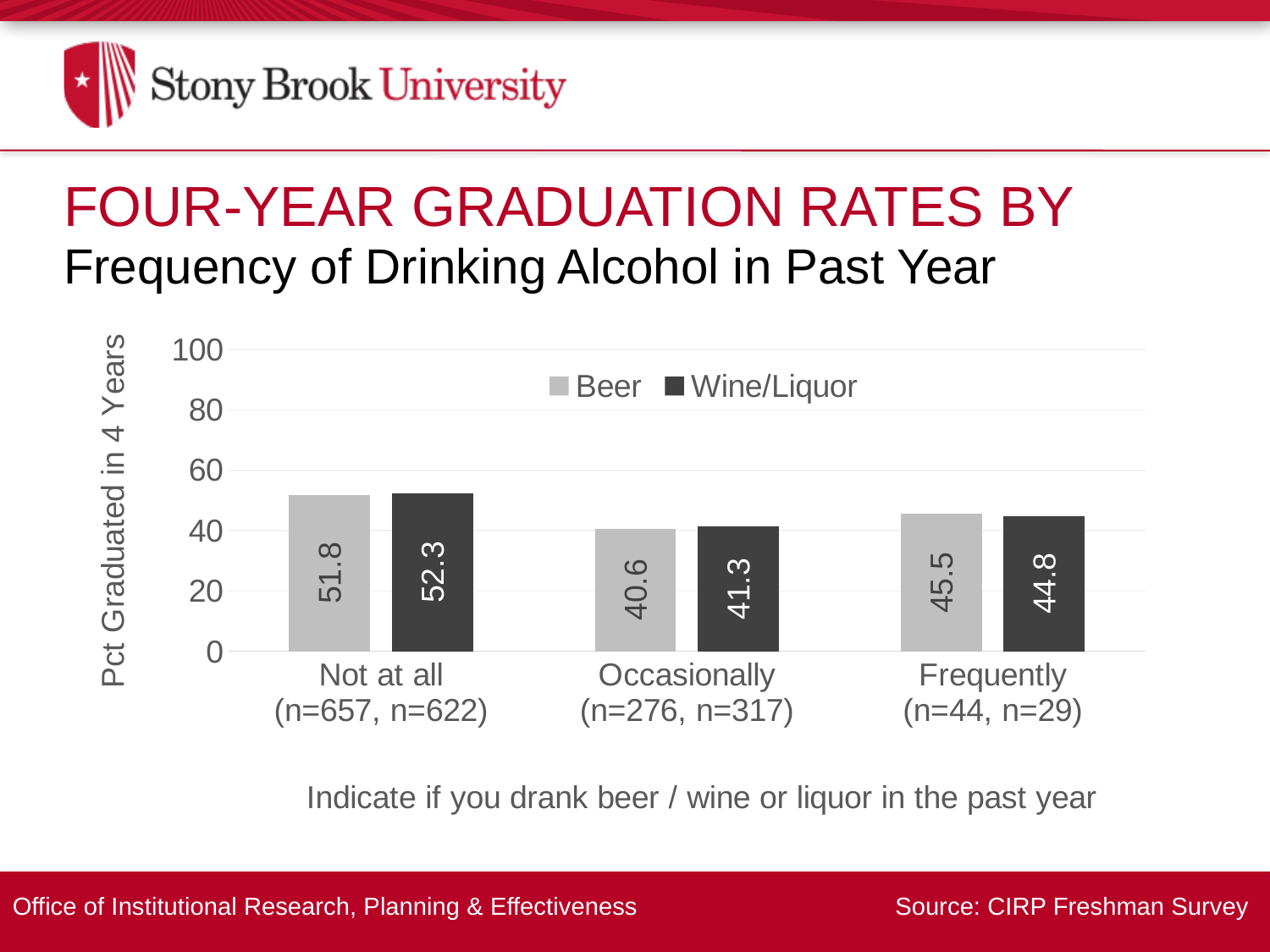
How many series does the legend list? 2 Which category has the lowest Beer graduation rate? Occasionally Is the Wine/Liquor value for Frequently greater or less than 60? less Which is larger: the Beer rate for Frequently or the Beer rate for Occasionally? Beer rate for Frequently What kind of chart is shown on the slide? bar chart What is the difference between the Wine/Liquor and Beer graduation rates in the Not at all category? 0.5 Which category has the highest Wine/Liquor graduation rate? Not at all What is the four-year graduation rate for Beer in the Frequently category? 45.5 What is the difference between the Beer graduation rates for Not at all and Occasionally? 11.2 What is the four-year graduation rate for Beer in the Not at all category? 51.8 How many categories are shown on the x axis? 3 What is the four-year graduation rate for Wine/Liquor in the Occasionally category? 41.3